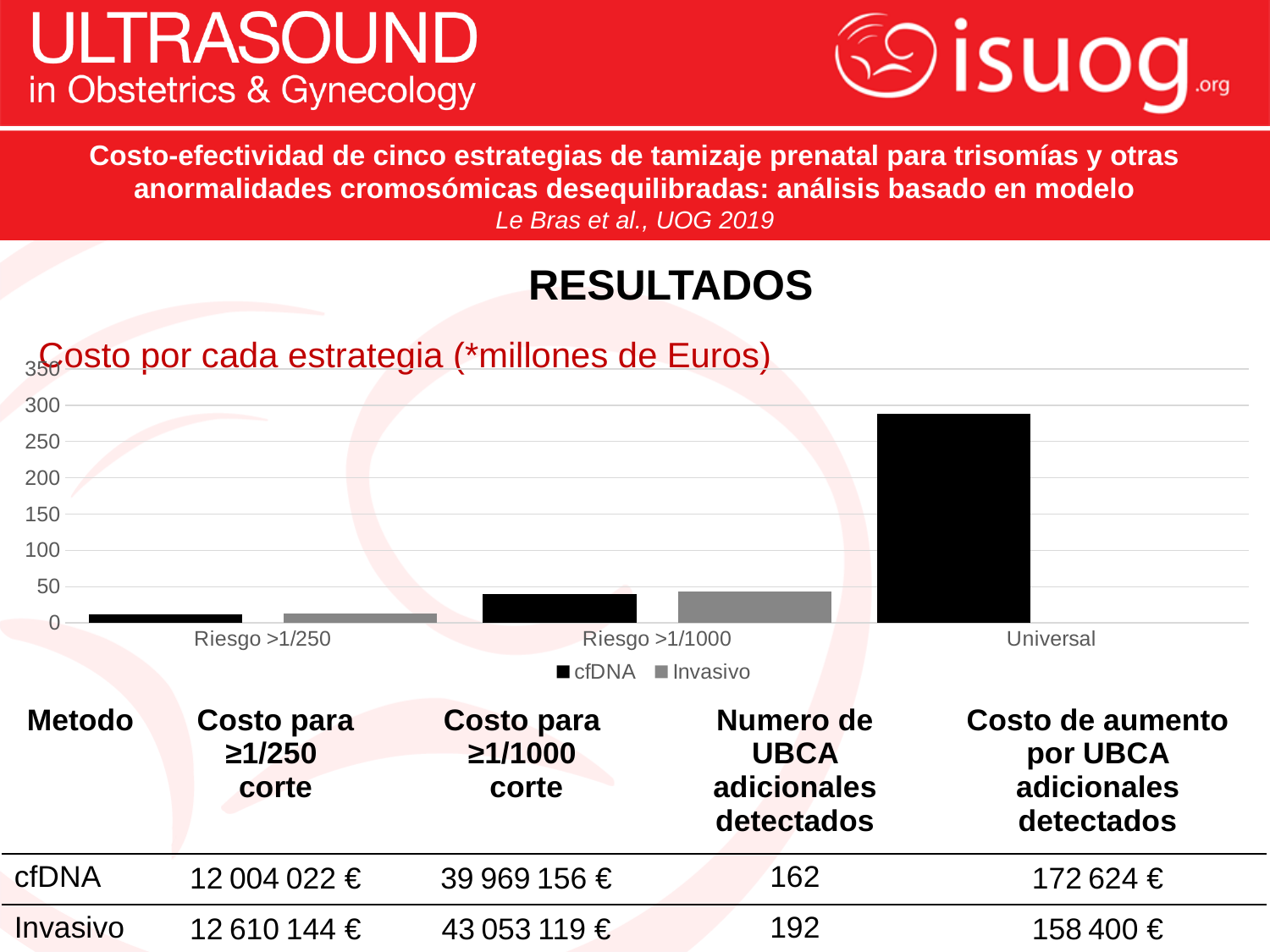
What is the title of the chart? Costo por cada estrategia (*millones de Euros) Which category has the lowest bars in the chart? Riesgo >1/250 Which is larger, the Invasivo value for Riesgo >1/1000 or the Invasivo value for Riesgo >1/250? Riesgo >1/1000 How many categories are shown on the x axis of the chart? 3 Which is larger, the cfDNA value for Universal or the cfDNA value for Riesgo >1/1000? Universal Is the cfDNA value for Riesgo >1/1000 greater or less than 50? less Which category has the tallest bar in the chart? Universal Do the cfDNA values rise or fall from Riesgo >1/250 to Universal along the x axis? rise Is the cfDNA value for Universal greater or less than 250? greater How many series does the chart legend list? 2 What kind of chart is shown on the slide? bar chart Is the Invasivo value for Riesgo >1/250 greater or less than 50? less